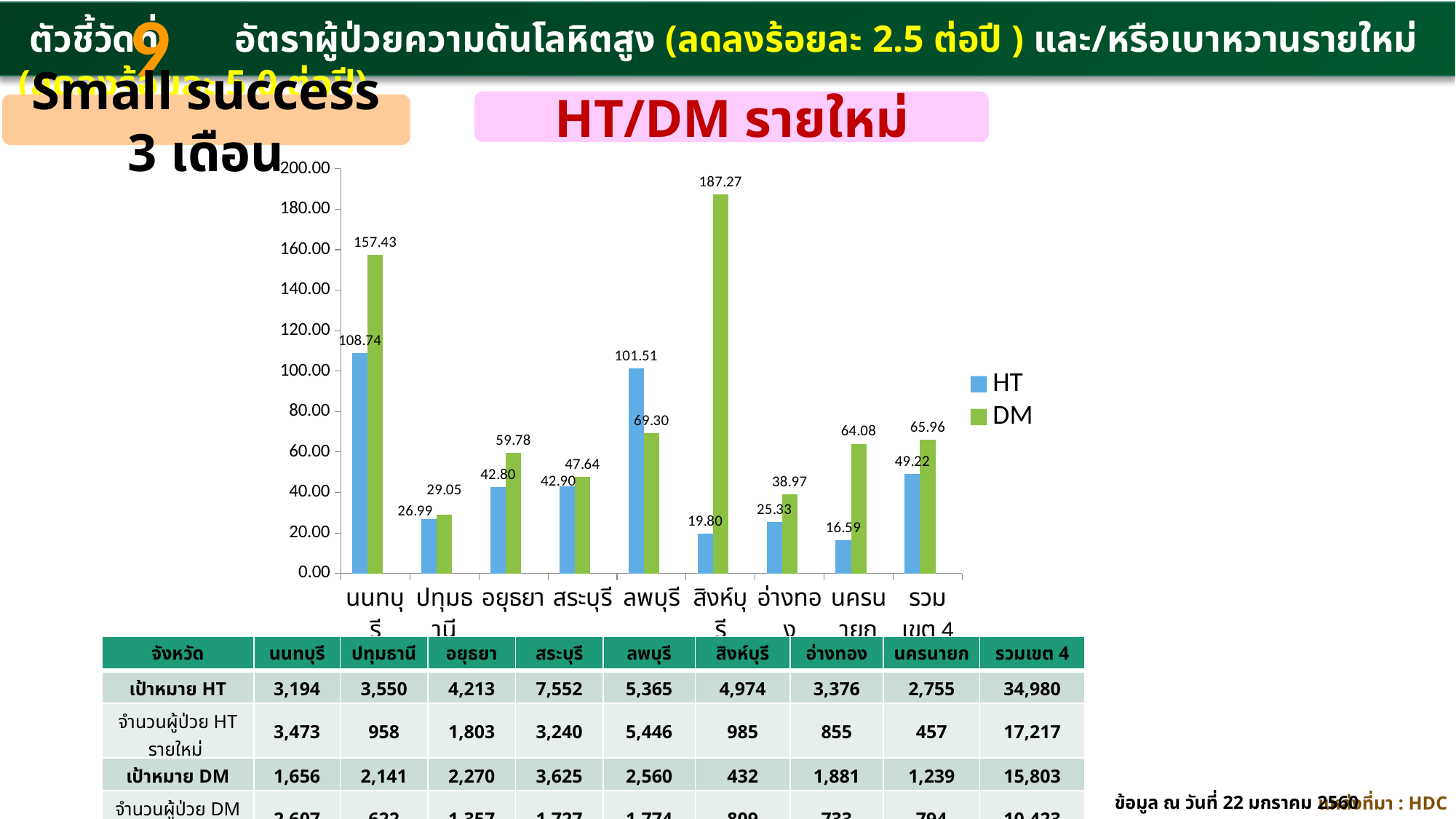
What is the title shown above the chart? HT/DM รายใหม่ What is the DM value for รวมเขต 4? 65.96 Which province has the highest DM value? สิงห์บุรี What is the HT value for นนทบุรี? 108.74 Which category has the lowest HT value? นครนายก What kind of chart is shown on the slide? bar chart What is the DM value for สิงห์บุรี? 187.27 Which is larger for ลพบุรี, the HT value or the DM value? HT What is the HT value for นครนายก? 16.59 What is the difference between the DM and HT values for นนทบุรี? 48.69 How many categories are shown on the x axis of the chart? 9 How many series does the chart legend list? 2